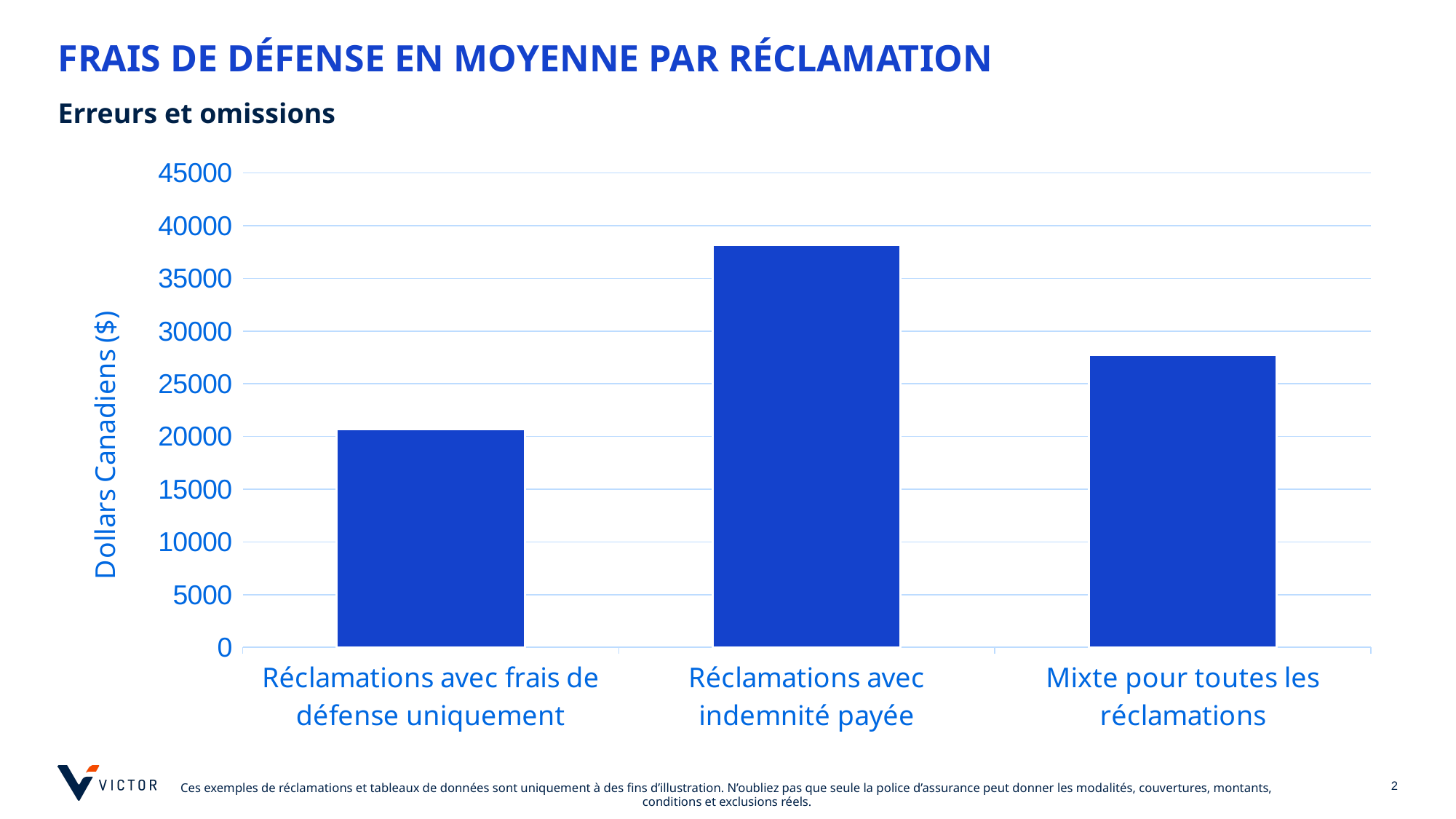
Which is larger: the value for 'Réclamations avec indemnité payée' or the value for 'Mixte pour toutes les réclamations'? Réclamations avec indemnité payée How many categories are shown on the x axis of the chart? 3 Is the value for 'Réclamations avec indemnité payée' greater or less than 35000? greater Is the value for 'Réclamations avec indemnité payée' greater or less than 40000? less What is the label on the vertical axis of the chart? Dollars Canadiens ($) What is the title of the slide containing the chart? FRAIS DE DÉFENSE EN MOYENNE PAR RÉCLAMATION Is the value for 'Mixte pour toutes les réclamations' greater or less than 30000? less What kind of chart is shown on the slide? bar chart Which category has the lowest average defence cost? Réclamations avec frais de défense uniquement Which category has the highest average defence cost? Réclamations avec indemnité payée Which is larger: the value for 'Mixte pour toutes les réclamations' or the value for 'Réclamations avec frais de défense uniquement'? Mixte pour toutes les réclamations